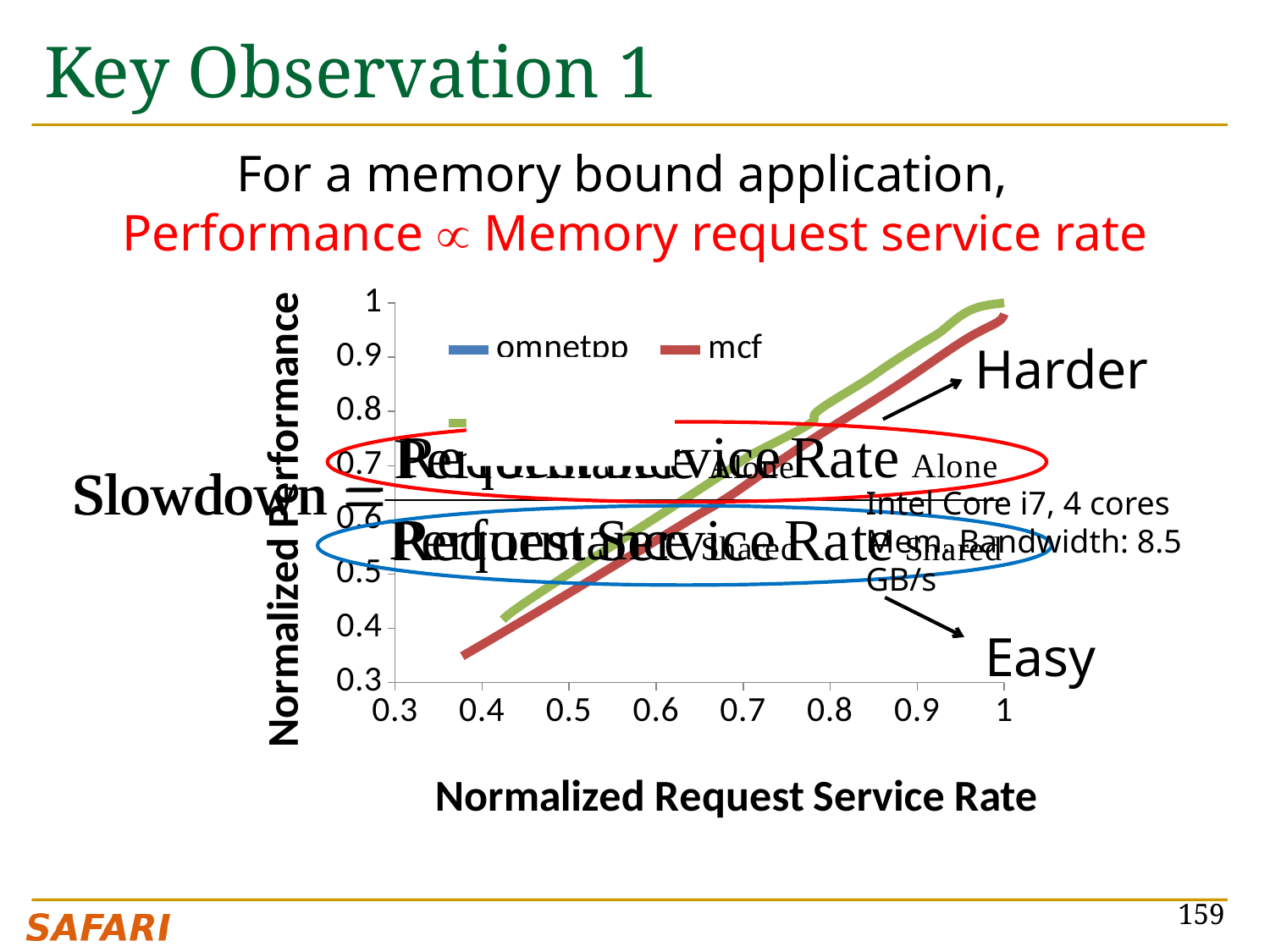
How many series does the chart's legend list? 2 What is the title of the chart's x axis? Normalized Request Service Rate Do the plotted values rise or fall as Normalized Request Service Rate increases along the x axis? rise How many tick labels are shown on the chart's x axis? 8 Is the Normalized Performance of omnetpp at a Normalized Request Service Rate of 0.8 greater or less than 0.7? greater What are the two series named in the chart's legend? omnetpp and mcf Is the Normalized Performance of mcf at a Normalized Request Service Rate of 0.4 greater or less than 0.5? less Which series has the lowest Normalized Performance value at its starting point on the chart? mcf Is the Normalized Performance of mcf at a Normalized Request Service Rate of 1 greater or less than 0.9? greater At a Normalized Request Service Rate of 0.9, which series has the higher Normalized Performance, omnetpp or mcf? omnetpp What kind of chart is shown on the slide? line chart